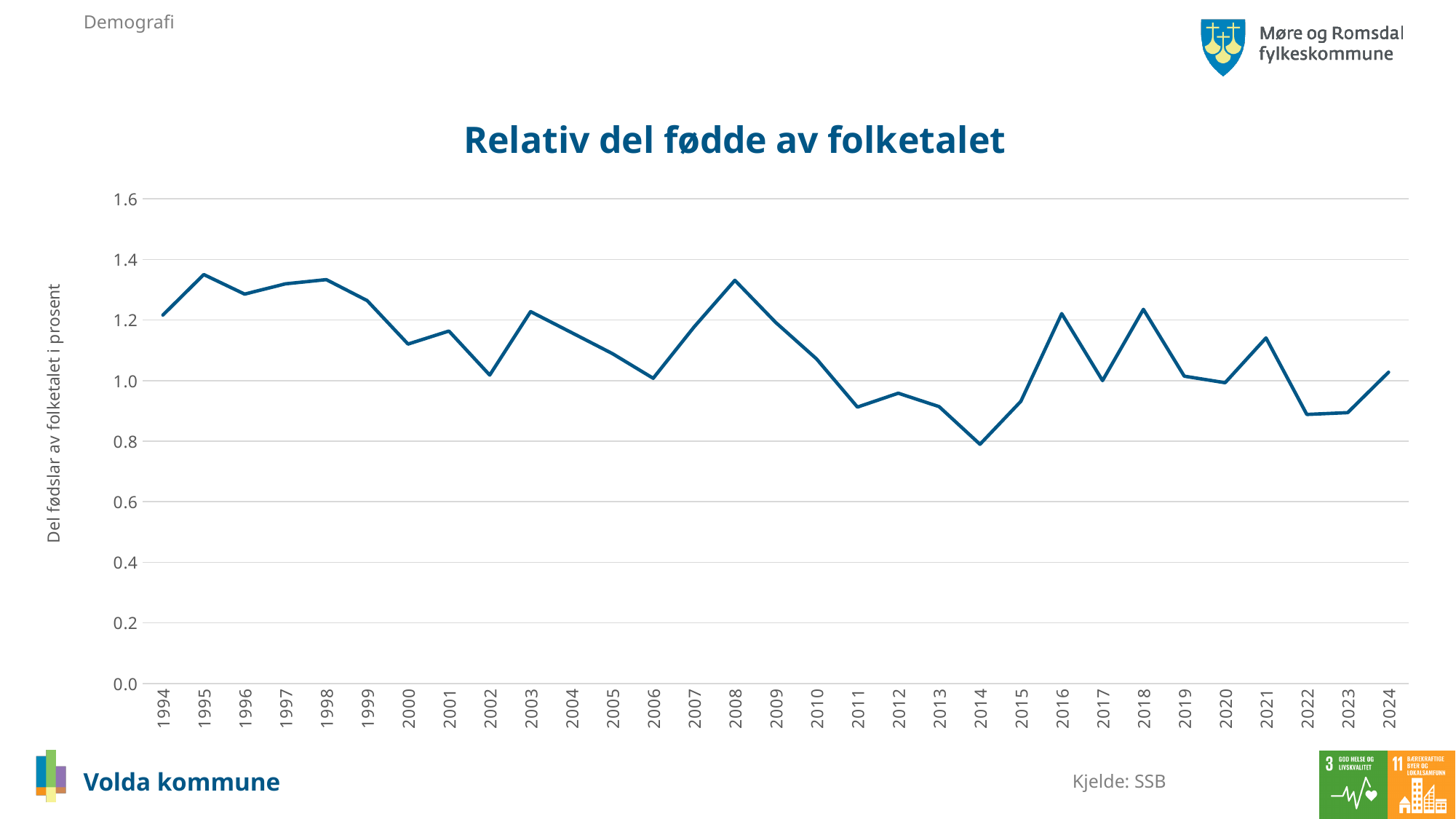
Does the value rise or fall from 2008 to 2014? fall Is the value for 1995 greater or less than 1.2? greater Is the value for 2022 greater or less than 1.0? less Which is larger, the value for 2018 or the value for 2022? 2018 How many years are plotted along the x axis of the chart? 31 What is the label on the vertical axis of the chart? Del fødslar av folketalet i prosent What kind of chart is shown on the slide? line chart Which year has the lowest value in the chart? 2014 What is the title of the chart? Relativ del fødde av folketalet Is the value for 2008 greater or less than 1.2? greater Which is larger, the value for 1995 or the value for 2014? 1995